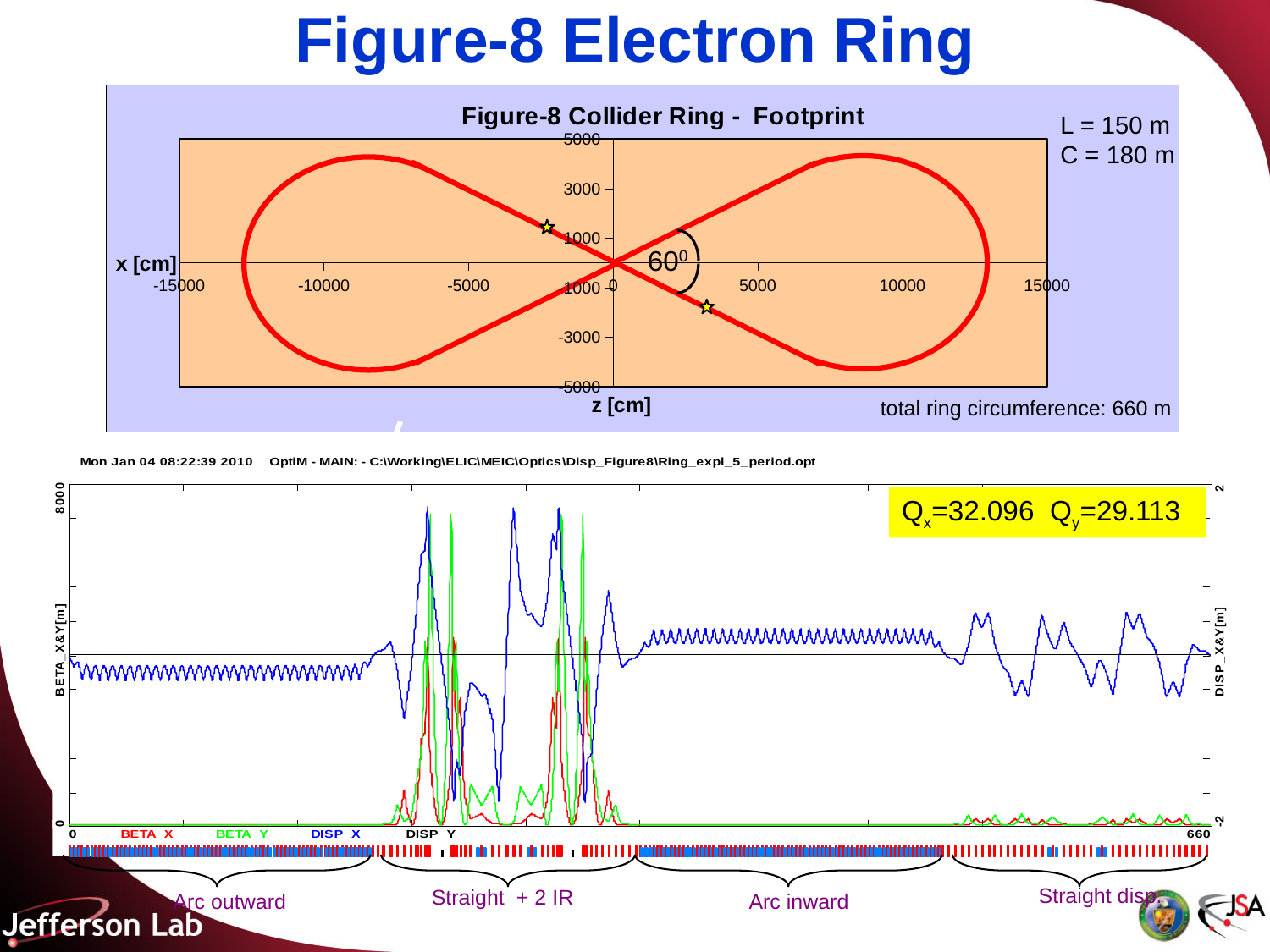
In the top chart (Figure-8 Collider Ring - Footprint), what value is given for C? 180 m In the bottom OptiM chart, what is the value of Q_x shown in the yellow box? 32.096 In the bottom OptiM chart, what is the value of Q_y shown in the yellow box? 29.113 In the top chart (Figure-8 Collider Ring - Footprint), what value is given for L? 150 m In the top chart (Figure-8 Collider Ring - Footprint), what total ring circumference is stated? 660 m In the top chart (Figure-8 Collider Ring - Footprint), what is the largest tick value shown on the horizontal z [cm] axis? 15000 What kind of chart is the top chart (Figure-8 Collider Ring - Footprint)? line chart What are the legend entries of the bottom OptiM chart? BETA_X, BETA_Y, DISP_X, DISP_Y In the bottom OptiM chart, which is larger, Q_x or Q_y? Q_x In the top chart (Figure-8 Collider Ring - Footprint), what crossing angle is marked at the centre of the figure-8? 60° What is the title of the top chart on the slide? Figure-8 Collider Ring - Footprint How many series does the legend of the bottom OptiM chart list? 4